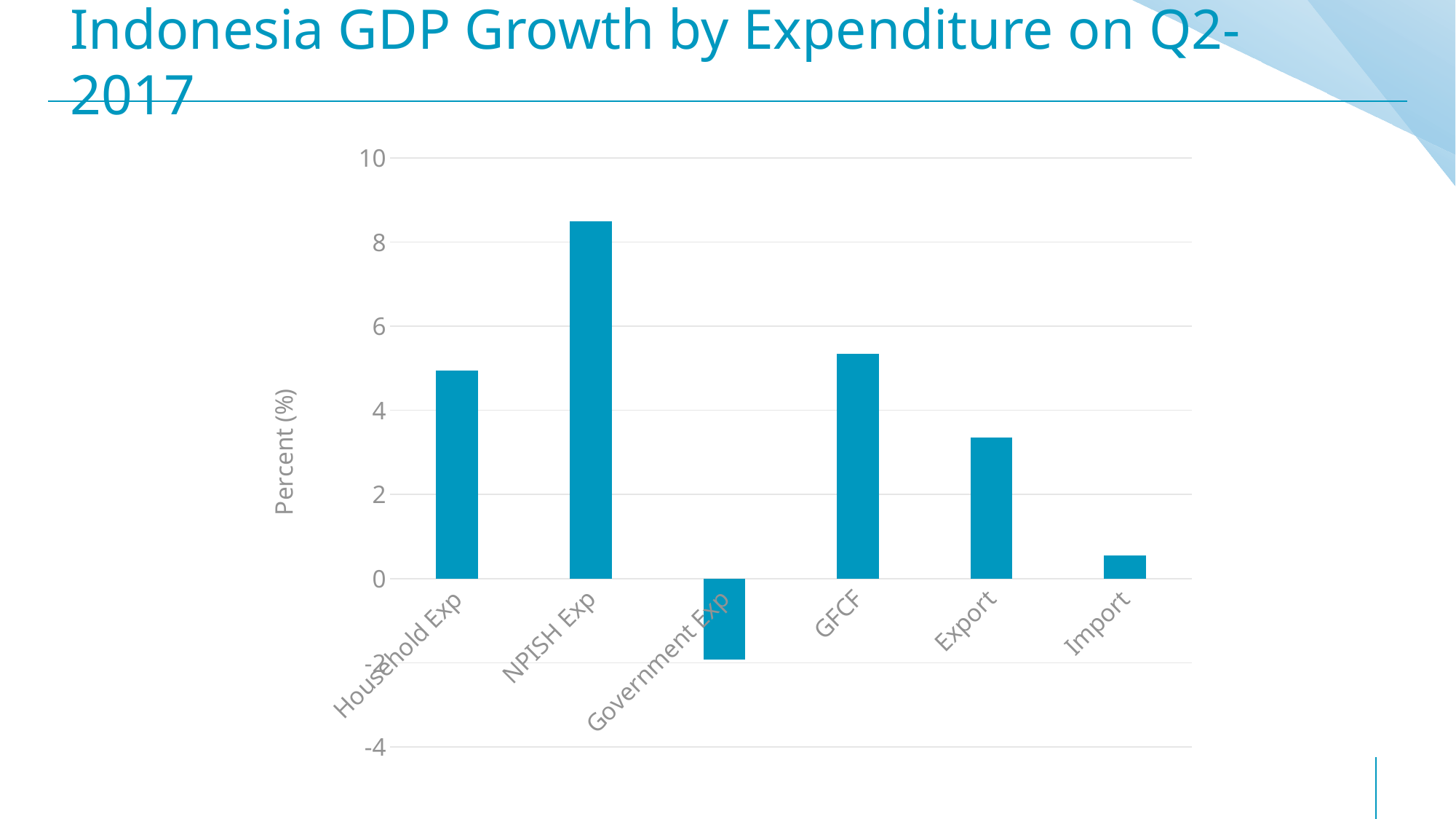
Which is larger, the value for GFCF or the value for Export? GFCF Which expenditure category has the lowest GDP growth in the chart? Government Exp Is the value for Government Exp greater or less than 0? less Is the value for Import greater or less than 2? less Is the value for Export greater or less than 4? less What is the label on the vertical axis of the chart? Percent (%) Which expenditure category has the highest GDP growth in the chart? NPISH Exp How many expenditure categories are plotted in the chart? 6 Which is larger, the value for Import or the value for Household Exp? Household Exp What kind of chart is shown on the slide? bar chart